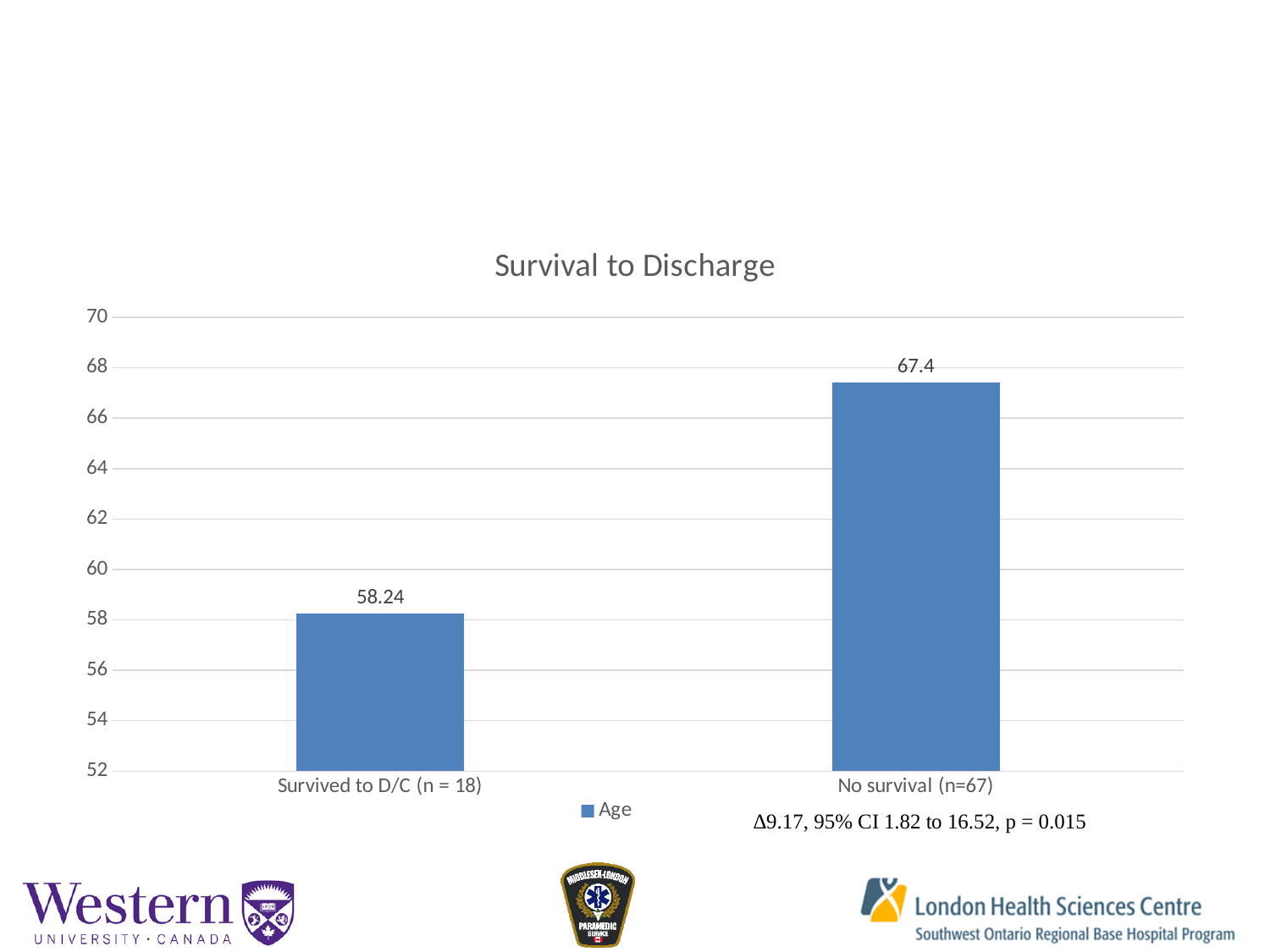
How many categories are shown on the x axis? 2 Which category has the lowest value? Survived to D/C (n = 18) Which category has the highest value? No survival (n=67) How many series does the legend list? 1 What is the title of the chart? Survival to Discharge Which is larger, the value for Survived to D/C (n = 18) or the value for No survival (n=67)? No survival (n=67) What is the value for Survived to D/C (n = 18)? 58.24 Is the value for No survival (n=67) greater or less than 66? greater Is the value for Survived to D/C (n = 18) greater or less than 60? less What is the value for No survival (n=67)? 67.4 What kind of chart is shown? bar chart What is the difference between the values for No survival (n=67) and Survived to D/C (n = 18)? 9.16